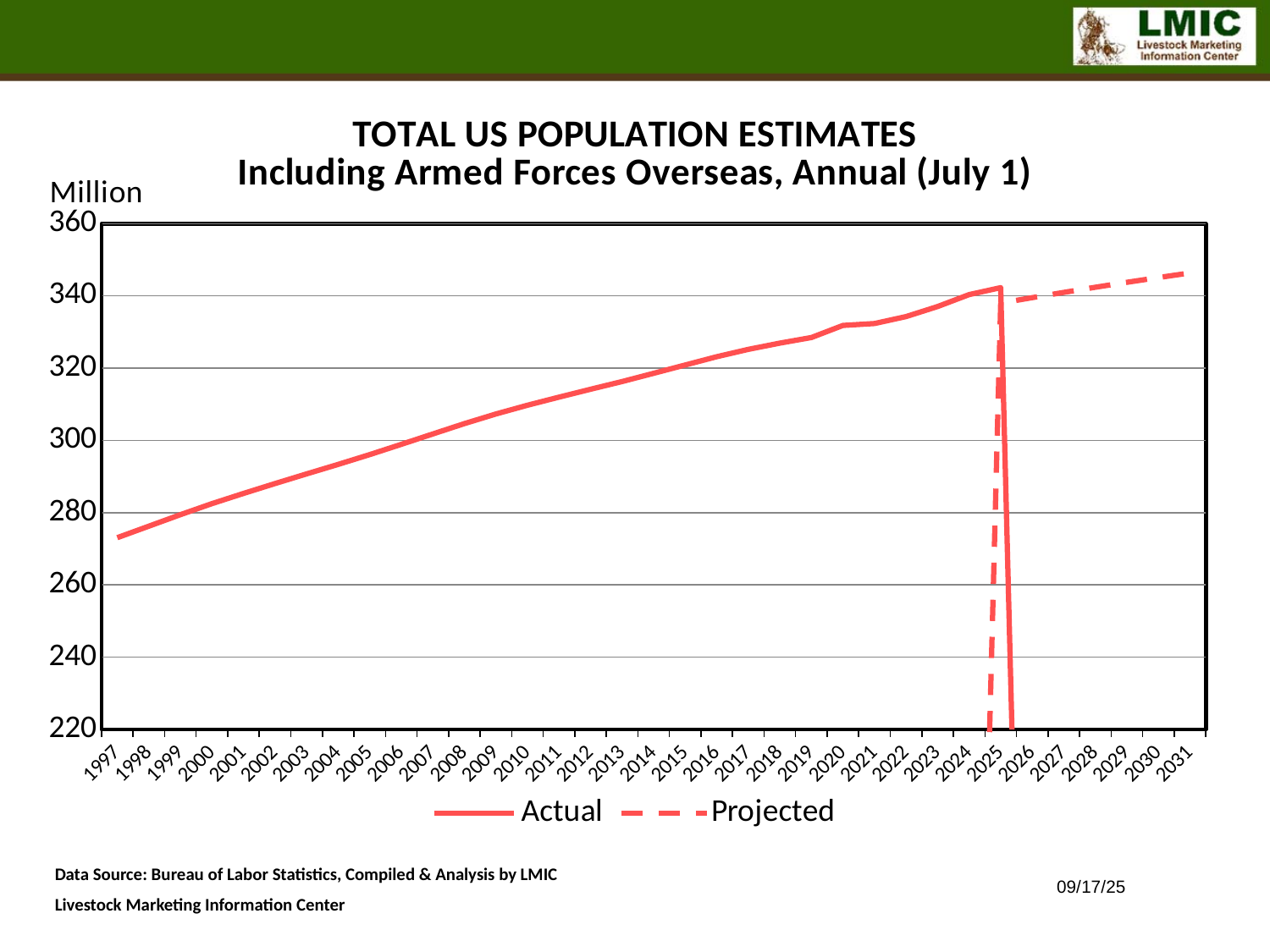
How many series does the legend list? 2 How many years are labeled along the x axis? 35 Which is larger, the Actual value for 2010 or the Actual value for 2020? 2020 Is the Actual value for 2010 greater or less than 300? greater Is the Actual value for 2003 greater or less than 300? less What are the two series named in the legend? Actual and Projected What kind of chart is shown on the slide? line chart Does the Actual series rise or fall from 1997 to 2024? rise Is the Actual value for 1997 greater or less than 280? less What unit is shown on the vertical axis label? Million